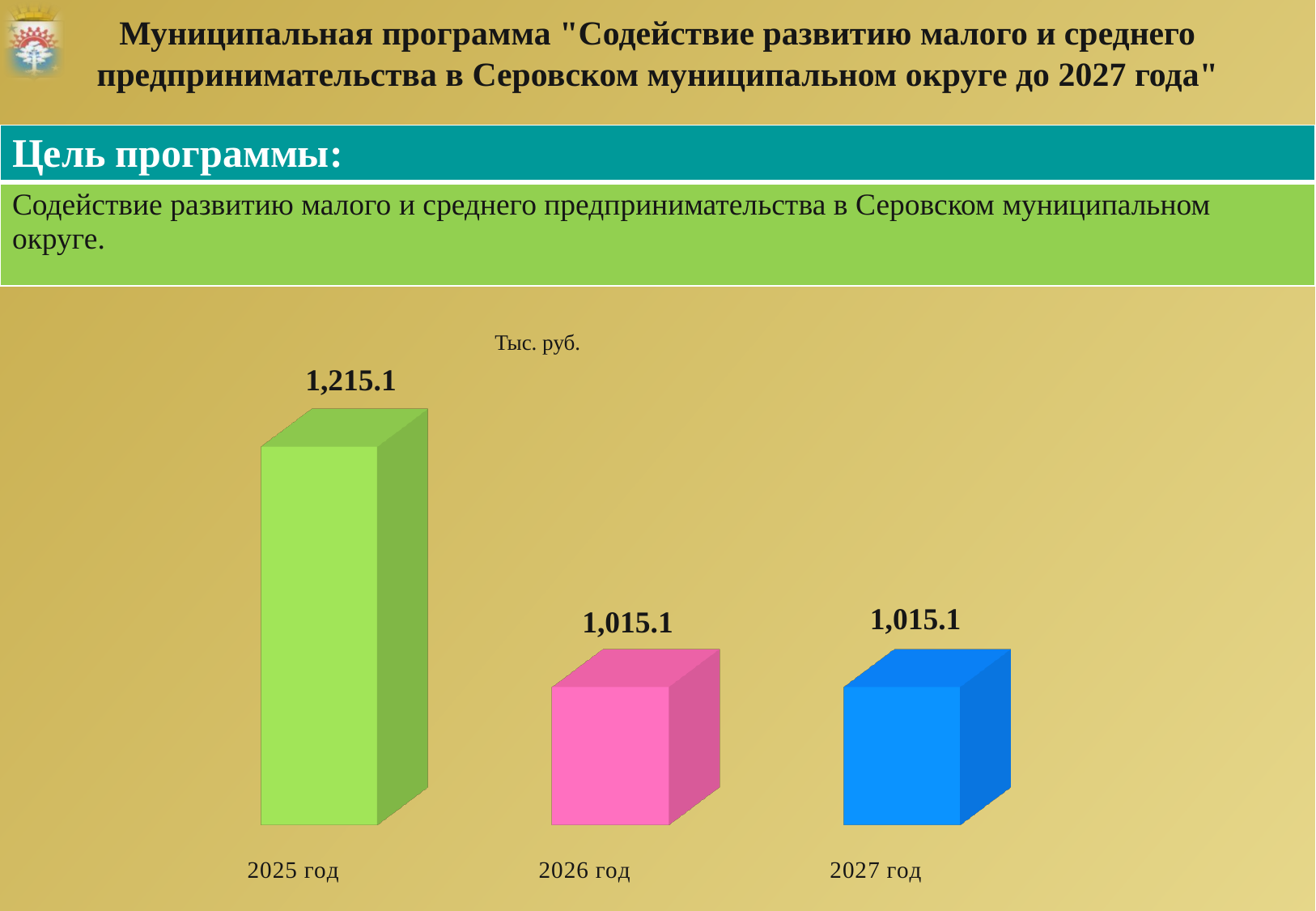
What is the difference between the values for 2025 год and 2026 год? 200.0 Which year has the highest value? 2025 год What kind of chart is shown on the slide? bar chart How many years are shown in the chart? 3 What is the value for 2026 год? 1,015.1 What is the value for 2027 год? 1,015.1 What colour is the bar for 2027 год? blue Which is larger, the value for 2025 год or the value for 2027 год? 2025 год What is the value for 2025 год? 1,215.1 What unit is indicated above the chart? Тыс. руб. Do the values rise or fall from 2025 год to 2026 год? fall